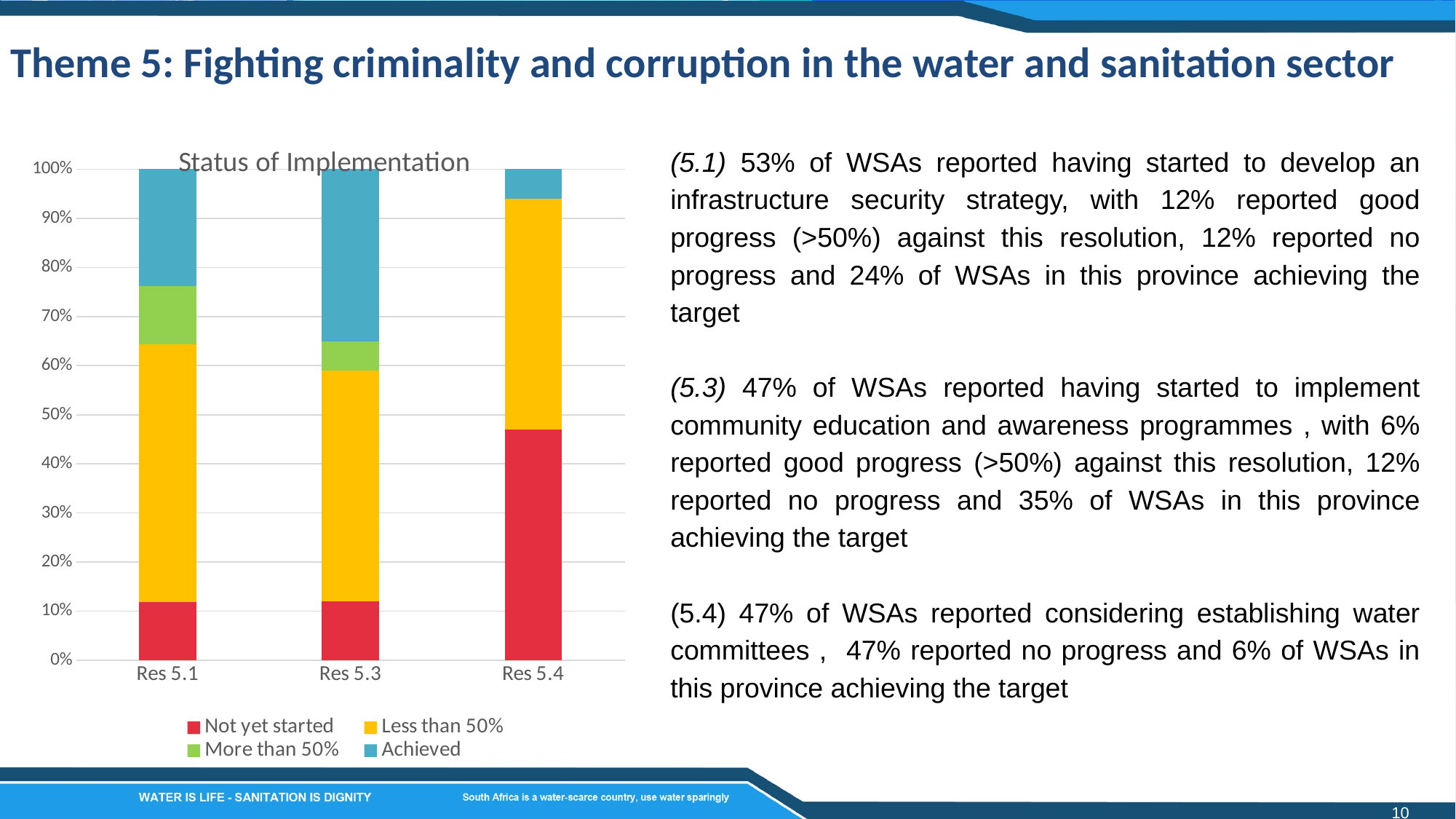
How many categories are shown on the x axis of the chart? 3 Which category has the largest 'Achieved' segment? Res 5.3 Which category has the largest 'Not yet started' segment? Res 5.4 Is the 'Not yet started' segment larger for Res 5.4 or for Res 5.1? Res 5.4 What is the title of the chart? Status of Implementation Is the 'Achieved' segment larger for Res 5.1 or for Res 5.4? Res 5.1 Which colour represents the 'Achieved' series in the chart? blue Which category has the smallest 'Achieved' segment? Res 5.4 Is the 'Not yet started' value for Res 5.1 greater or less than 20%? less What kind of chart is shown on the slide? bar chart Is the 'Not yet started' value for Res 5.4 greater or less than 40%? greater How many series does the chart legend list? 4